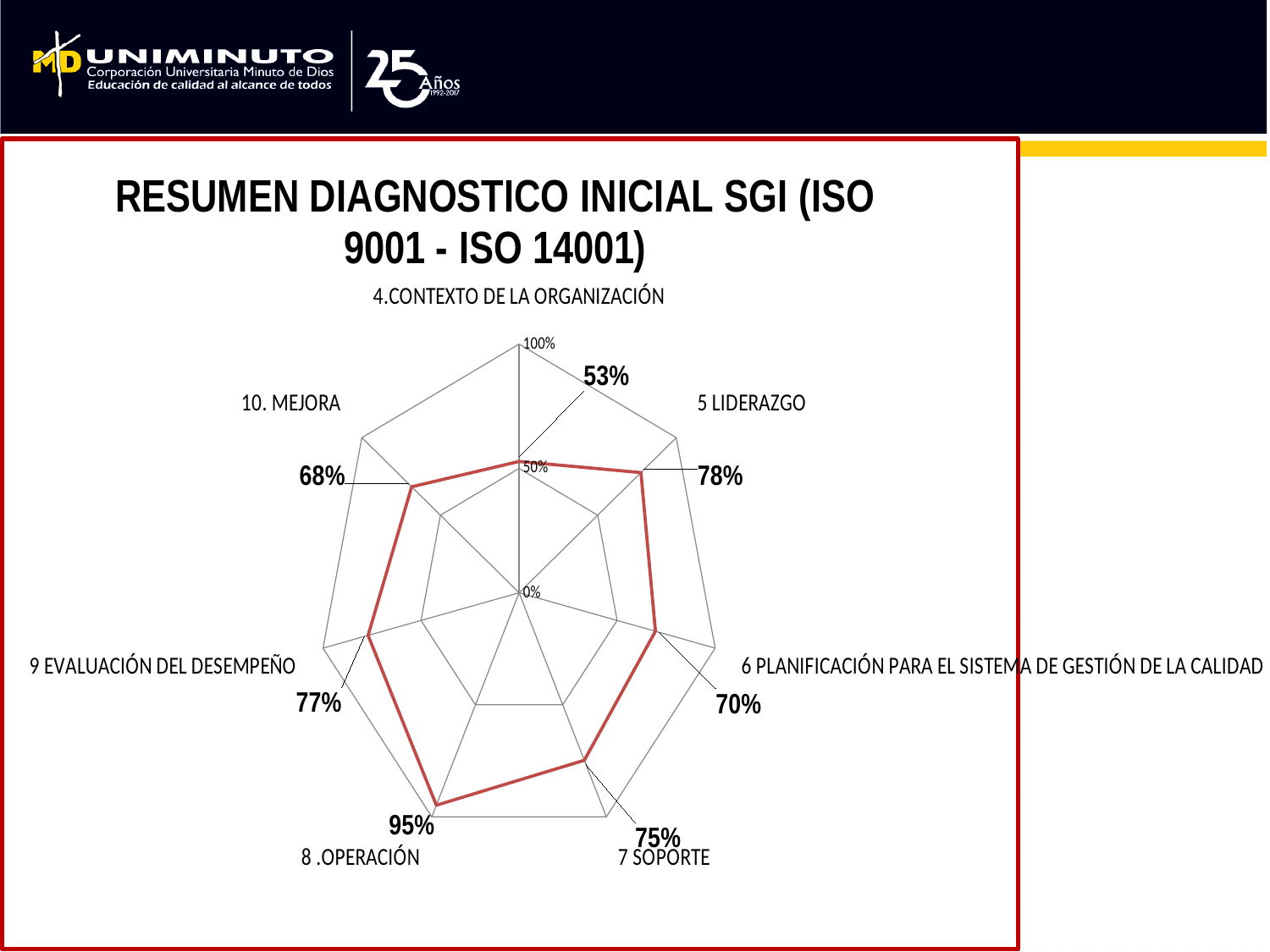
Is the value for 10. MEJORA greater or less than 50%? greater What is the title of the chart? RESUMEN DIAGNOSTICO INICIAL SGI (ISO 9001 - ISO 14001) What is the value for 8 .OPERACIÓN? 95% Which category has the lowest value? 4.CONTEXTO DE LA ORGANIZACIÓN What kind of chart is shown on the slide? Radar chart What is the value for 4.CONTEXTO DE LA ORGANIZACIÓN? 53% How many categories are plotted on the chart? 7 What is the value for 5 LIDERAZGO? 78% Which category has the highest value? 8 .OPERACIÓN What is the difference between the values for 8 .OPERACIÓN and 4.CONTEXTO DE LA ORGANIZACIÓN? 42% What is the value for 9 EVALUACIÓN DEL DESEMPEÑO? 77% Which is larger, the value for 5 LIDERAZGO or the value for 6 PLANIFICACIÓN PARA EL SISTEMA DE GESTIÓN DE LA CALIDAD? 5 LIDERAZGO